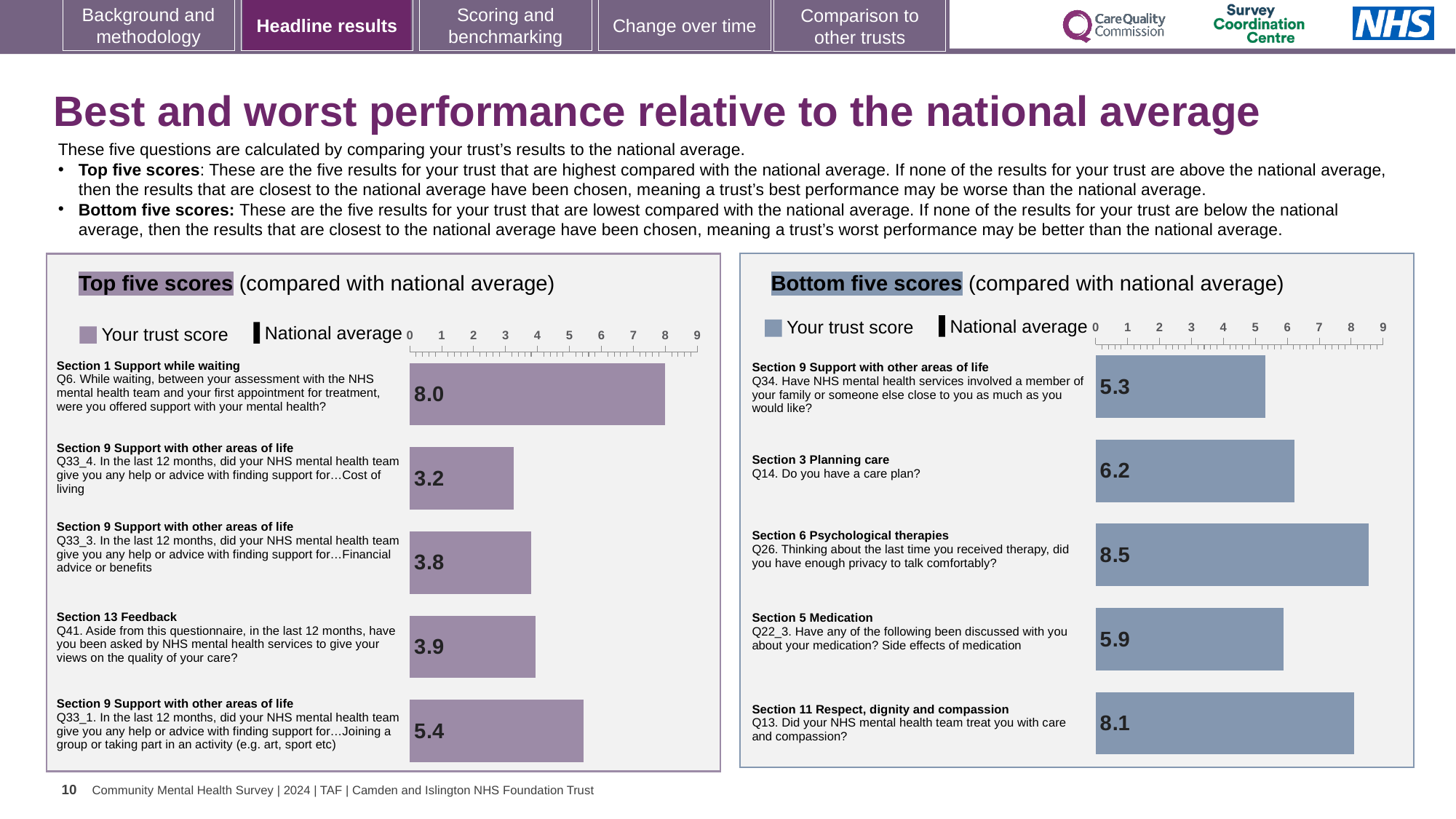
How many series does the legend of the Top five scores chart list? 2 How many bars are plotted in the Bottom five scores chart? 5 In the Bottom five scores chart, what is the trust score for Q26 (Section 6 Psychological therapies)? 8.5 In the Top five scores chart, what is the trust score for Q41 (Section 13 Feedback)? 3.9 What kind of chart is the Top five scores chart? Bar chart In the Top five scores chart, which question has the highest trust score? Q6 (Section 1 Support while waiting) In the Bottom five scores chart, which question has the highest trust score? Q26 (Section 6 Psychological therapies) In the Top five scores chart, which question has the lowest trust score? Q33_4 (Cost of living) In the Top five scores chart, what is the difference between the trust scores for Q6 and Q33_1? 2.6 In the Bottom five scores chart, which has the larger trust score: Q14 (care plan) or Q22_3 (side effects of medication)? Q14 (6.2) In the Bottom five scores chart, which question has the lowest trust score? Q34 (Section 9 Support with other areas of life) In the Top five scores chart, what is the trust score for Q6 (Section 1 Support while waiting)? 8.0